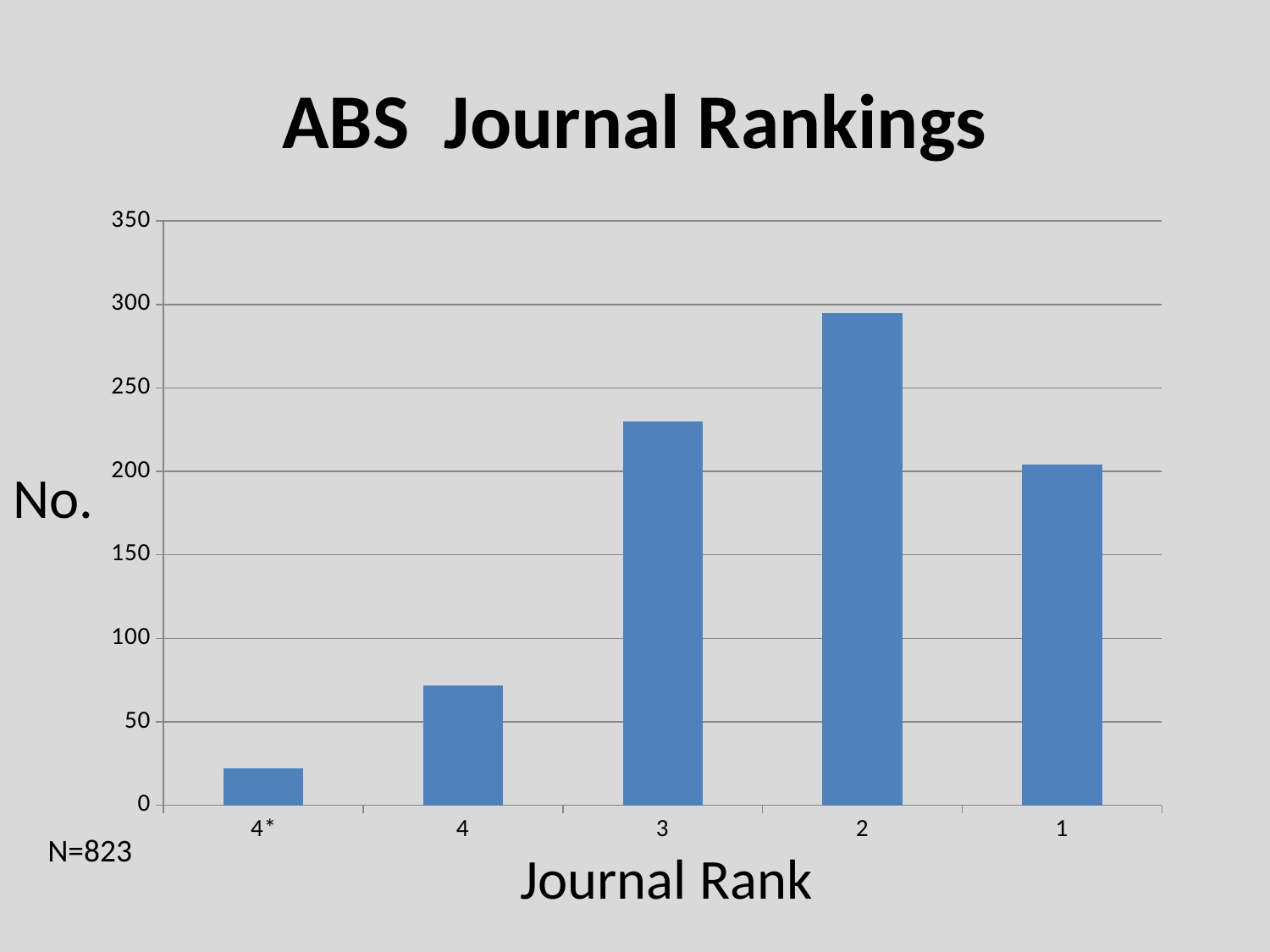
Which journal rank has the highest number of journals? 2 How many journal rank categories are shown on the x axis? 5 What kind of chart is shown on the slide? bar chart Is the value for journal rank 4 greater or less than 100? less Which journal rank has the lowest number of journals? 4* Is the value for journal rank 4* greater or less than 50? less Is the value for journal rank 3 greater or less than 200? greater What is the title of the chart? ABS Journal Rankings What is the label of the x axis? Journal Rank Which has a larger value, journal rank 4 or journal rank 4*? 4 Which has a larger value, journal rank 3 or journal rank 1? 3